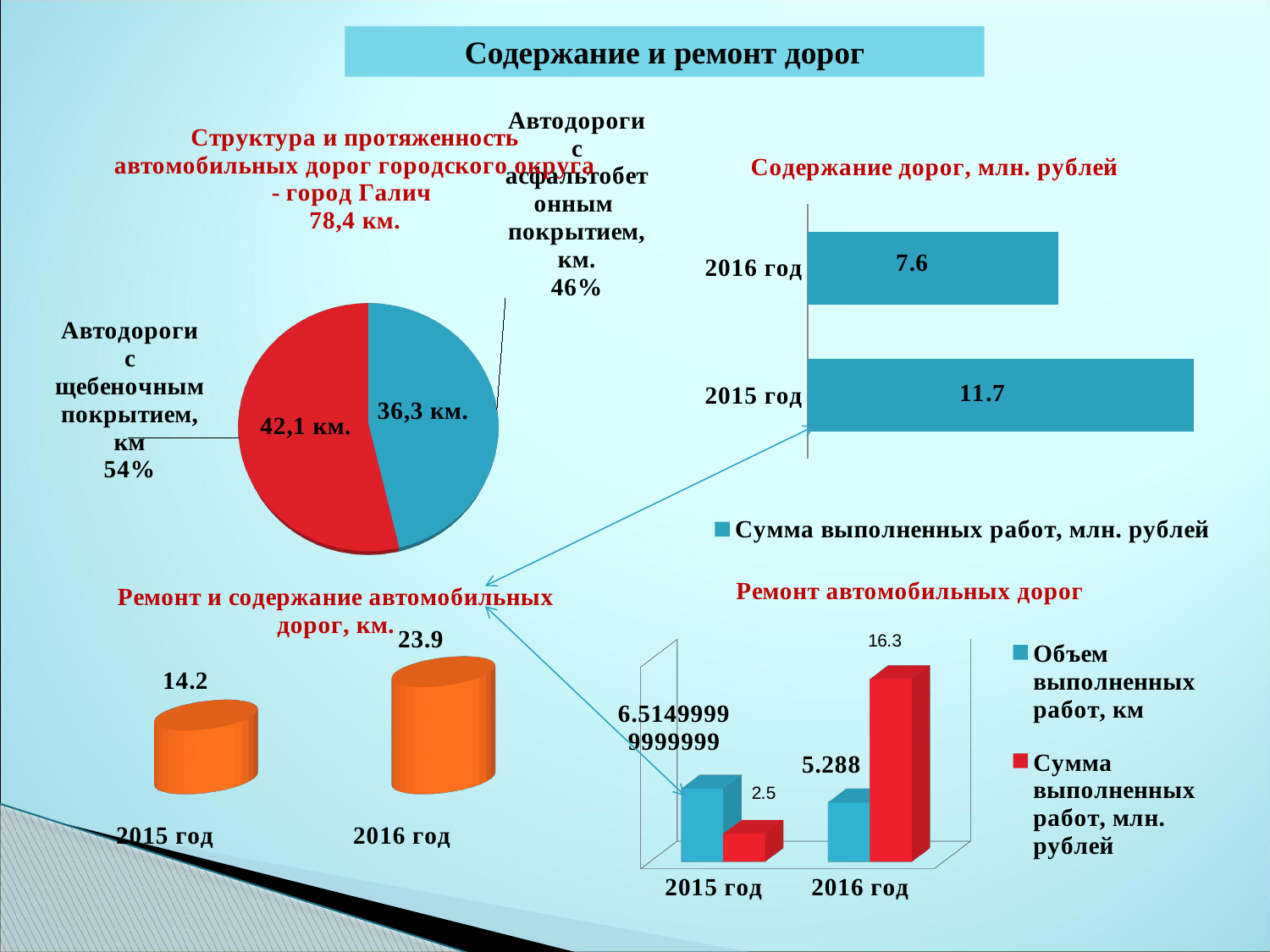
In the chart 'Ремонт автомобильных дорог', what is the value of 'Сумма выполненных работ, млн. рублей' for 2016 год? 16.3 In the chart 'Ремонт и содержание автомобильных дорог, км', do the values rise or fall from 2015 год to 2016 год? Rise In the pie chart 'Структура и протяженность автомобильных дорог городского округа - город Галич', what share of the pie is 'Автодороги с асфальтобетонным покрытием'? 46% In the chart 'Ремонт и содержание автомобильных дорог, км', which year has the lowest value? 2015 год In the pie chart 'Структура и протяженность автомобильных дорог городского округа - город Галич', which slice is larger: 'Автодороги с щебеночным покрытием' or 'Автодороги с асфальтобетонным покрытием'? Автодороги с щебеночным покрытием How many series does the legend of the chart 'Ремонт автомобильных дорог' list? 2 In the chart 'Содержание дорог, млн. рублей', what is the difference between the values for 2015 год and 2016 год? 4.1 In the pie chart 'Структура и протяженность автомобильных дорог городского округа - город Галич', what is the value for 'Автодороги с щебеночным покрытием'? 42,1 км. In the chart 'Ремонт и содержание автомобильных дорог, км', what is the value for 2016 год? 23.9 In the chart 'Ремонт автомобильных дорог', what is the value of 'Объем выполненных работ, км' for 2016 год? 5.288 In the chart 'Содержание дорог, млн. рублей', what is the value for 2015 год? 11.7 What kind of chart is 'Содержание дорог, млн. рублей'? Bar chart